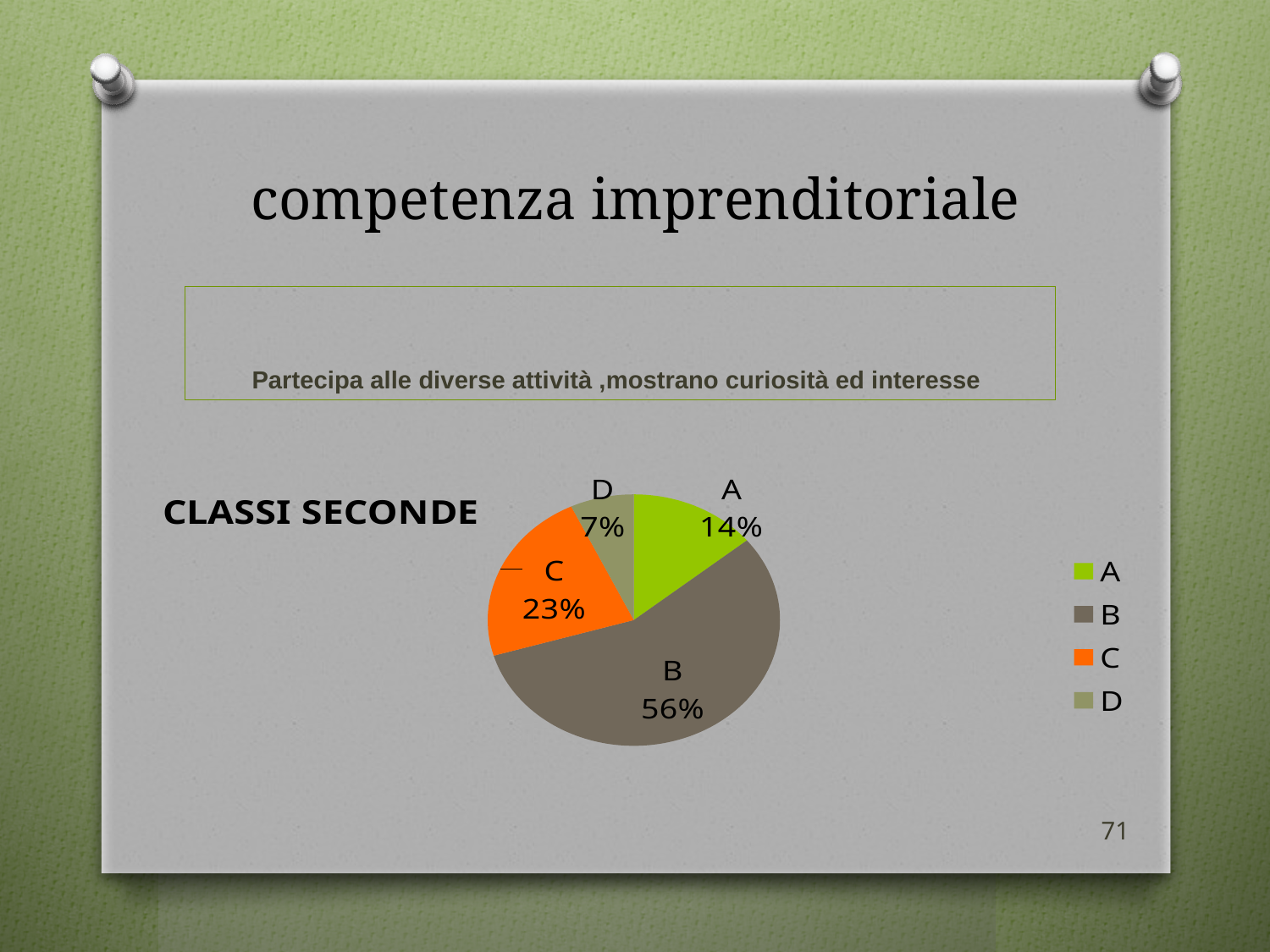
What percentage does slice D represent in the pie chart? 7% What is the difference in percentage points between slice B and slice C? 33 What colour is slice C in the pie chart? orange How many slices does the pie chart have? 4 What percentage does slice B represent in the pie chart? 56% Which is larger in the pie chart, slice A or slice C? C What percentage does slice C represent in the pie chart? 23% Which slice of the pie chart is the largest? B Which slice of the pie chart is the smallest? D How many entries does the legend of the pie chart list? 4 What kind of chart is shown on the slide? pie chart What percentage does slice A represent in the pie chart? 14%